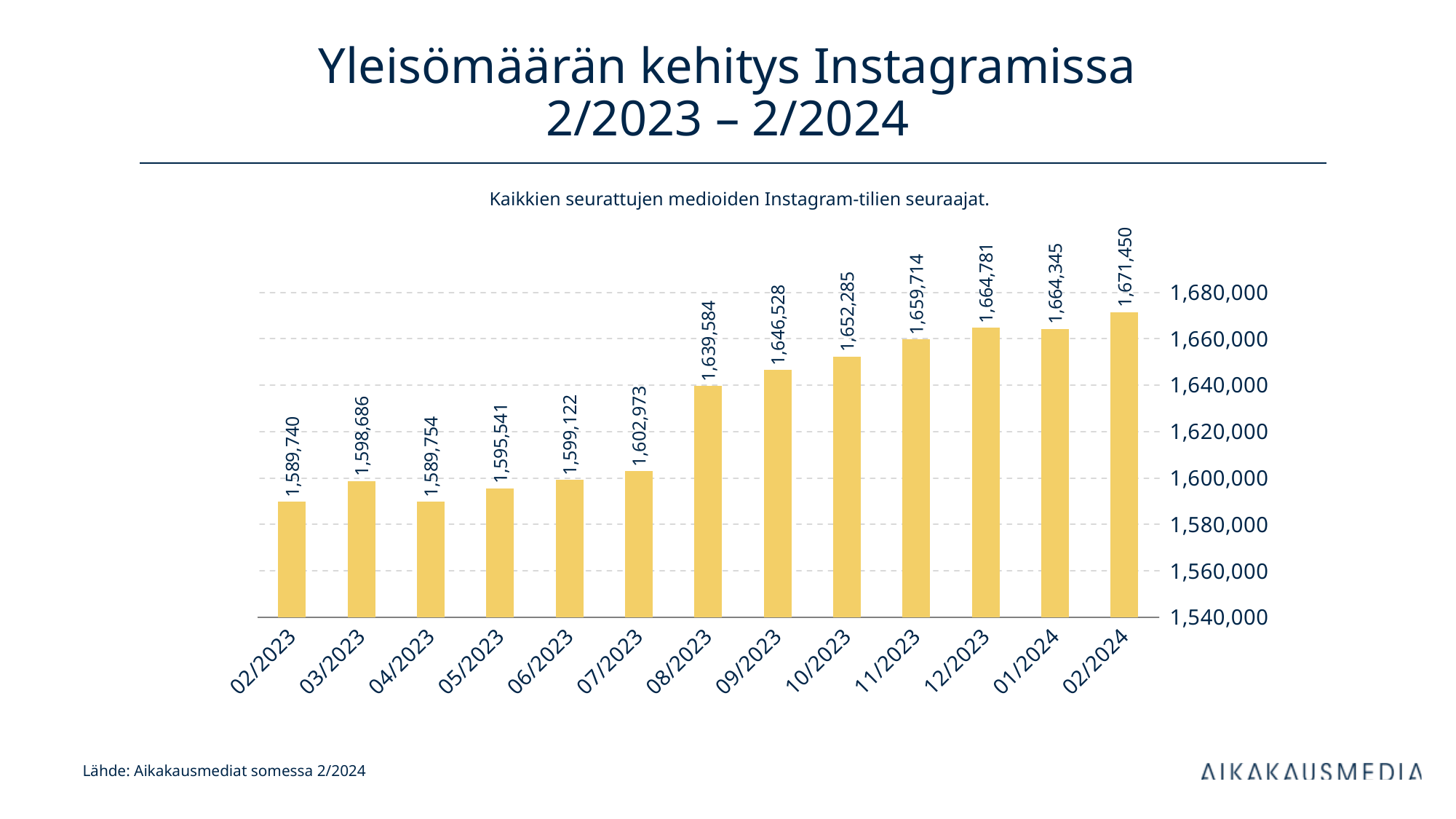
What is the value for 02/2023? 1,589,740 What kind of chart is shown on the slide? bar chart What is the difference between the values for 08/2023 and 07/2023? 36,611 What is the value for 12/2023? 1,664,781 How many months are shown on the x axis? 13 What is the value for 02/2024? 1,671,450 What is the difference between the values for 02/2024 and 02/2023? 81,710 Which month has the highest value? 02/2024 Which is larger, the value for 10/2023 or the value for 06/2023? 10/2023 Do the values generally rise or fall from 02/2023 to 02/2024? rise Is the value for 07/2023 greater or less than 1,620,000? less What is the value for 08/2023? 1,639,584